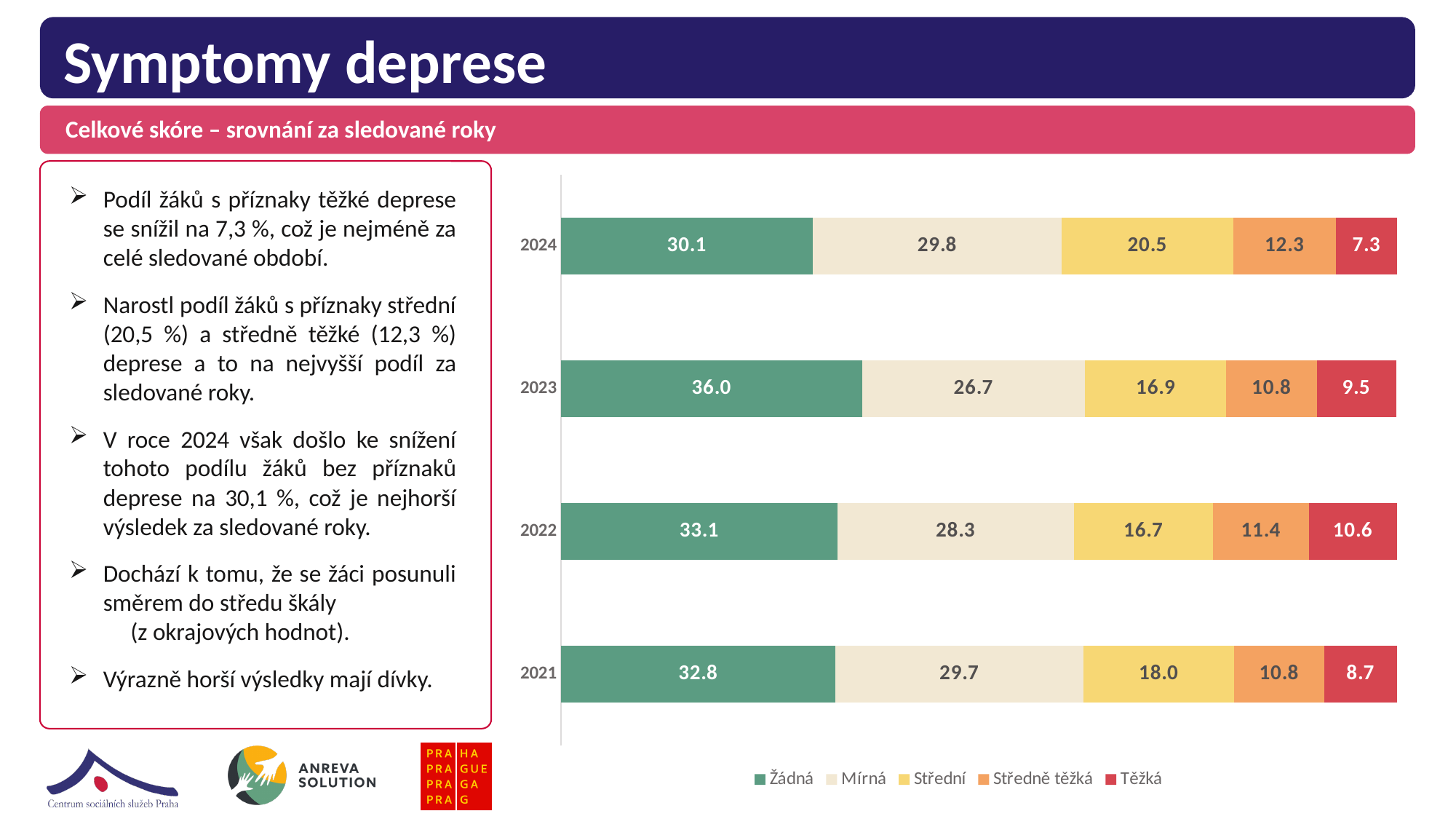
Which year has the highest value for Žádná? 2023 How many years (categories) are shown in the chart? 4 What is the value for Těžká in 2023? 9.5 What type of chart is shown on the slide? Stacked bar chart Which year has the lowest value for Těžká? 2024 What is the total of the stacked bar for 2024? 100.0 What is the value for Střední in 2021? 18.0 Which legend entry is shown in red? Těžká What is the value for Žádná in 2024? 30.1 What is the difference between the Žádná values for 2023 and 2024? 5.9 How many series does the legend list? 5 Which is larger: Středně těžká in 2022 or Středně těžká in 2021? 2022